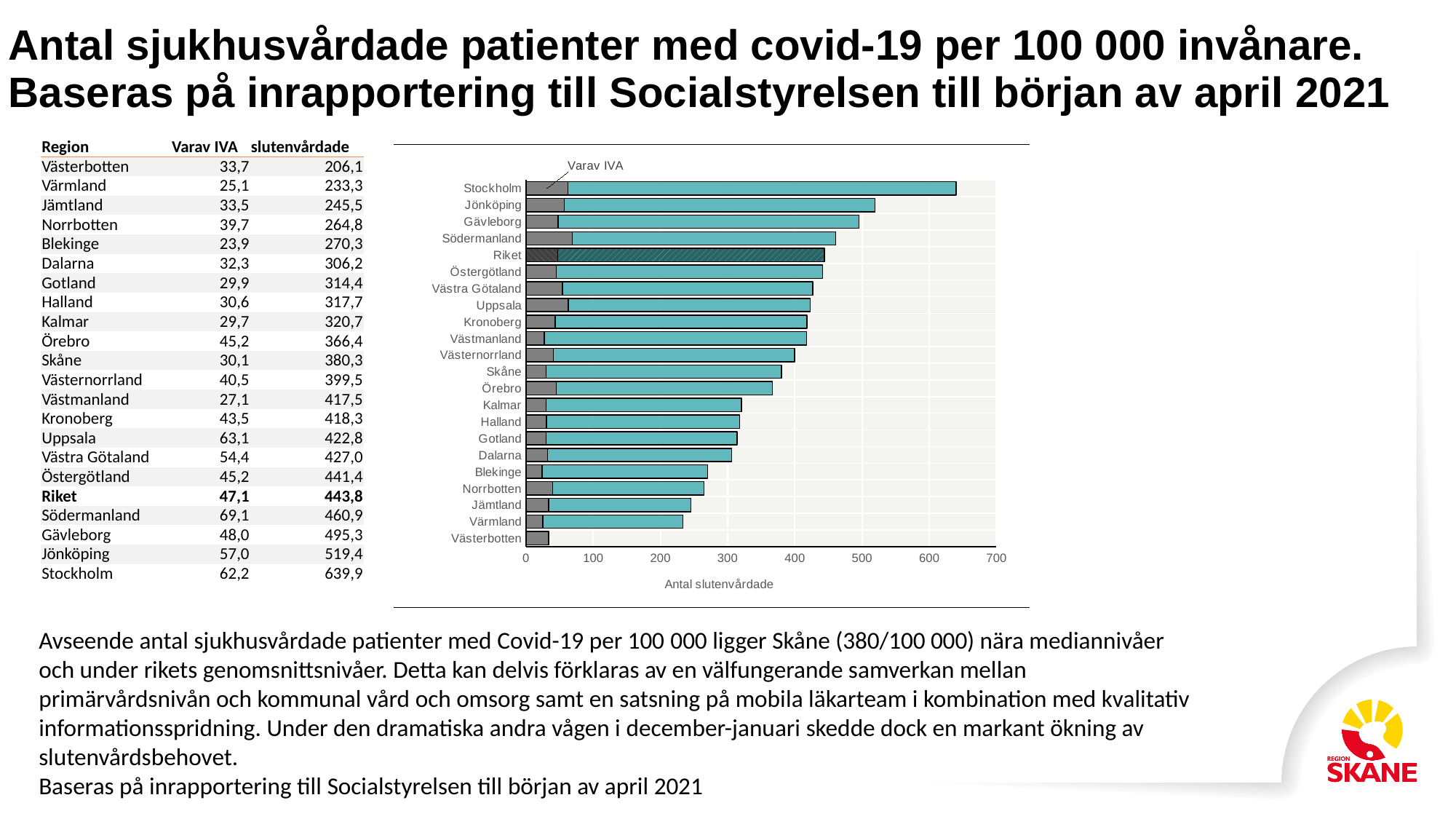
What is the value of slutenvårdade for Riket? 443,8 Is the slutenvårdade value for Västerbotten greater or less than 300? less What is the title of the x axis of the chart? Antal slutenvårdade Which region has the highest number of slutenvårdade per 100 000 in the chart? Stockholm Is the slutenvårdade value for Stockholm greater or less than 600? greater What is the Varav IVA value for Uppsala? 63,1 Which region has the lowest number of slutenvårdade per 100 000 in the chart? Västerbotten What is the value of slutenvårdade for Skåne? 380,3 What is the difference in slutenvårdade between Stockholm and Skåne? 259,6 What kind of chart is shown on the slide? bar chart How many bars (regions including Riket) are shown in the chart? 22 Which has a higher slutenvårdade value, Jönköping or Gävleborg? Jönköping